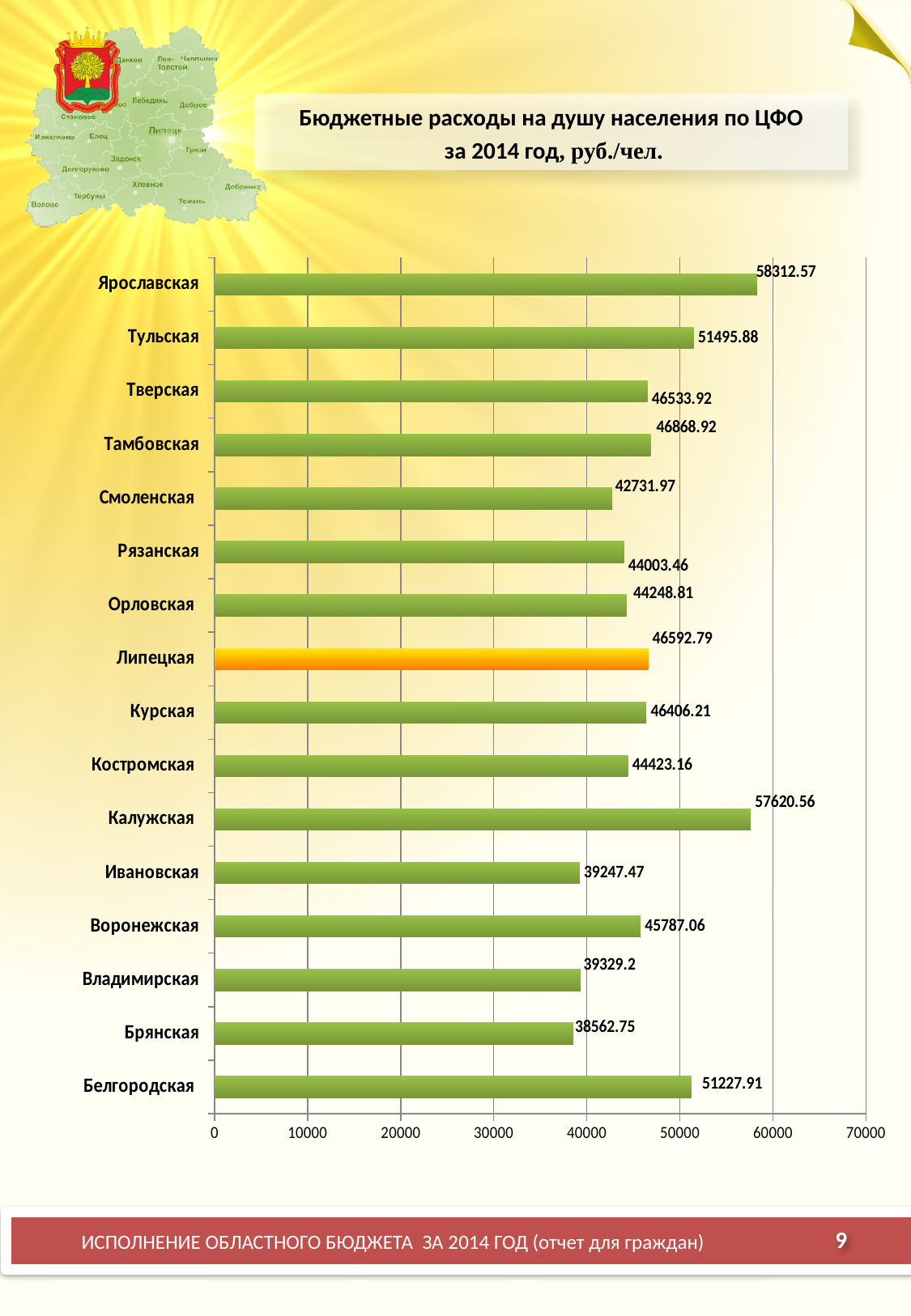
Which region has the lowest value? Брянская What is the value for Владимирская? 39329.2 Is the value for Ивановская greater or less than 40000? less What is the difference between the values for Ярославская and Калужская? 692.01 What is the difference between the values for Тульская and Белгородская? 267.97 Which region has the highest value? Ярославская What is the value for Ярославская? 58312.57 Which is larger, the value for Тамбовская or the value for Смоленская? Тамбовская What is the value for Липецкая? 46592.79 What kind of chart is shown on the slide? bar chart How many regions are shown in the chart? 16 Which region's bar is highlighted in a different colour (orange) from the others? Липецкая